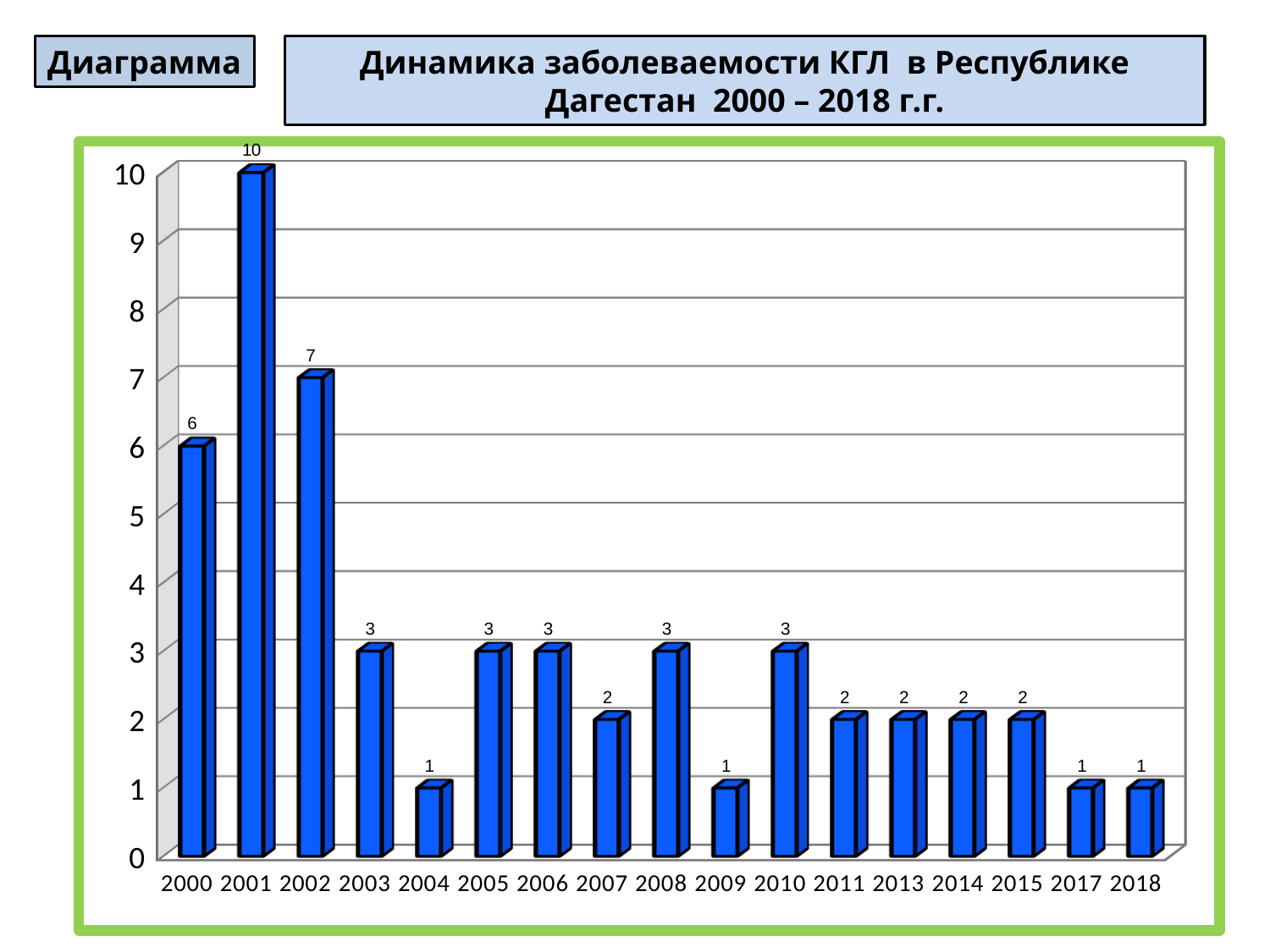
What is the lowest value shown on the chart? 1 What is the title of the chart? Динамика заболеваемости КГЛ в Республике Дагестан 2000 – 2018 г.г. How many years are shown on the x axis? 17 What is the value for 2000? 6 What is the value for 2001? 10 What is the difference between the values for 2000 and 2004? 5 What is the difference between the values for 2001 and 2002? 3 What is the value for 2002? 7 What is the value for 2014? 2 What kind of chart is this? bar chart Which is larger, the value for 2003 or the value for 2007? 2003 Which year has the highest value? 2001